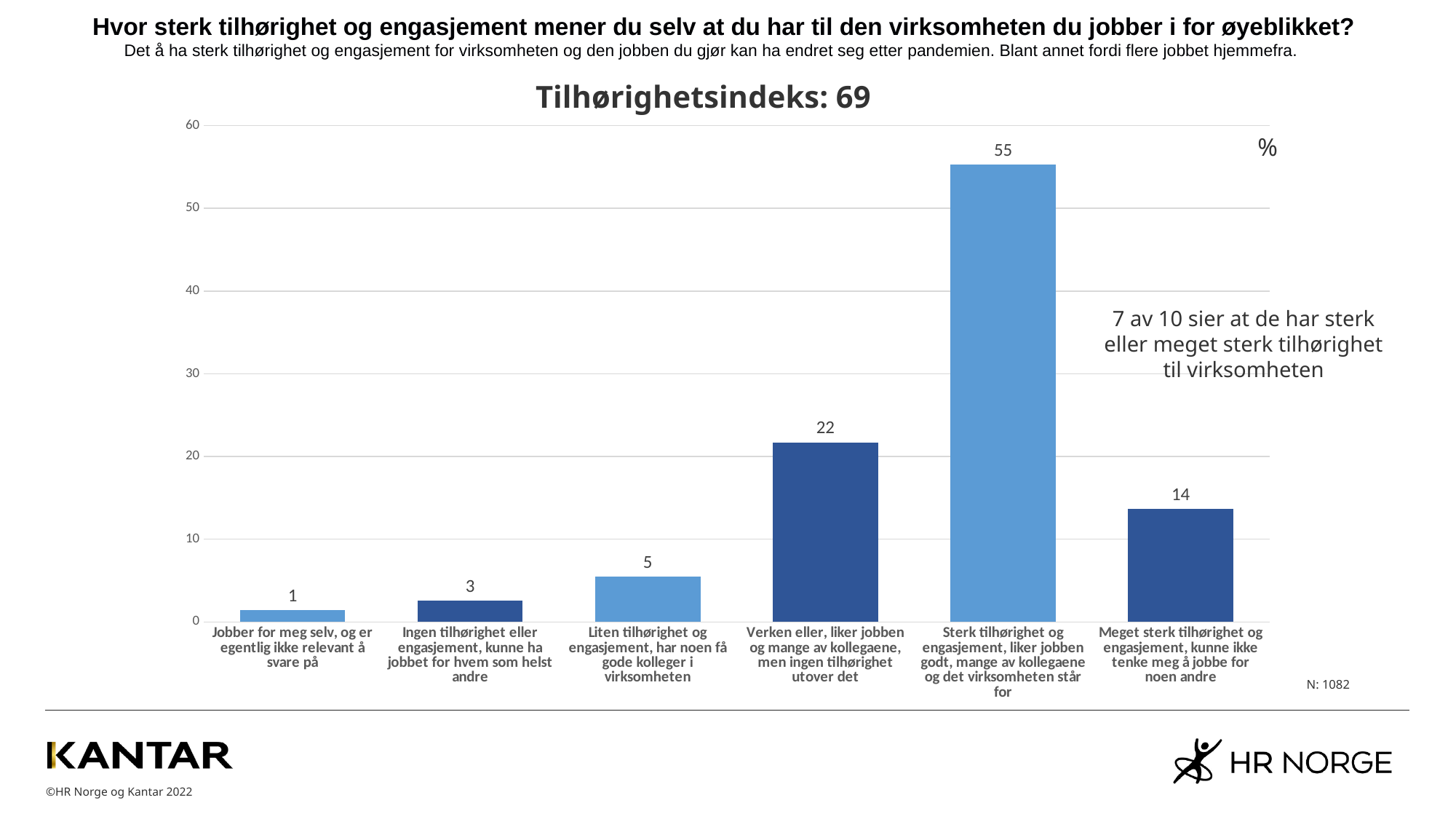
What kind of chart is shown on the slide? bar chart What is the difference between the values for "Sterk tilhørighet og engasjement..." (55) and "Verken eller..." (22)? 33 What is the value for "Meget sterk tilhørighet og engasjement, kunne ikke tenke meg å jobbe for noen andre"? 14 Which is larger: the value for "Verken eller..." or the value for "Meget sterk tilhørighet og engasjement..."? Verken eller, liker jobben og mange av kollegaene, men ingen tilhørighet utover det What is the value for "Verken eller, liker jobben og mange av kollegaene, men ingen tilhørighet utover det"? 22 Which category has the highest value? Sterk tilhørighet og engasjement, liker jobben godt, mange av kollegaene og det virksomheten står for Is the value for "Sterk tilhørighet og engasjement..." greater or less than 50? greater What is the chart's title? Tilhørighetsindeks: 69 What is the value for "Sterk tilhørighet og engasjement, liker jobben godt, mange av kollegaene og det virksomheten står for"? 55 Which category has the lowest value? Jobber for meg selv, og er egentlig ikke relevant å svare på How many categories are shown in the chart? 6 What is the difference between the values for "Meget sterk tilhørighet og engasjement..." and "Liten tilhørighet og engasjement..."? 9